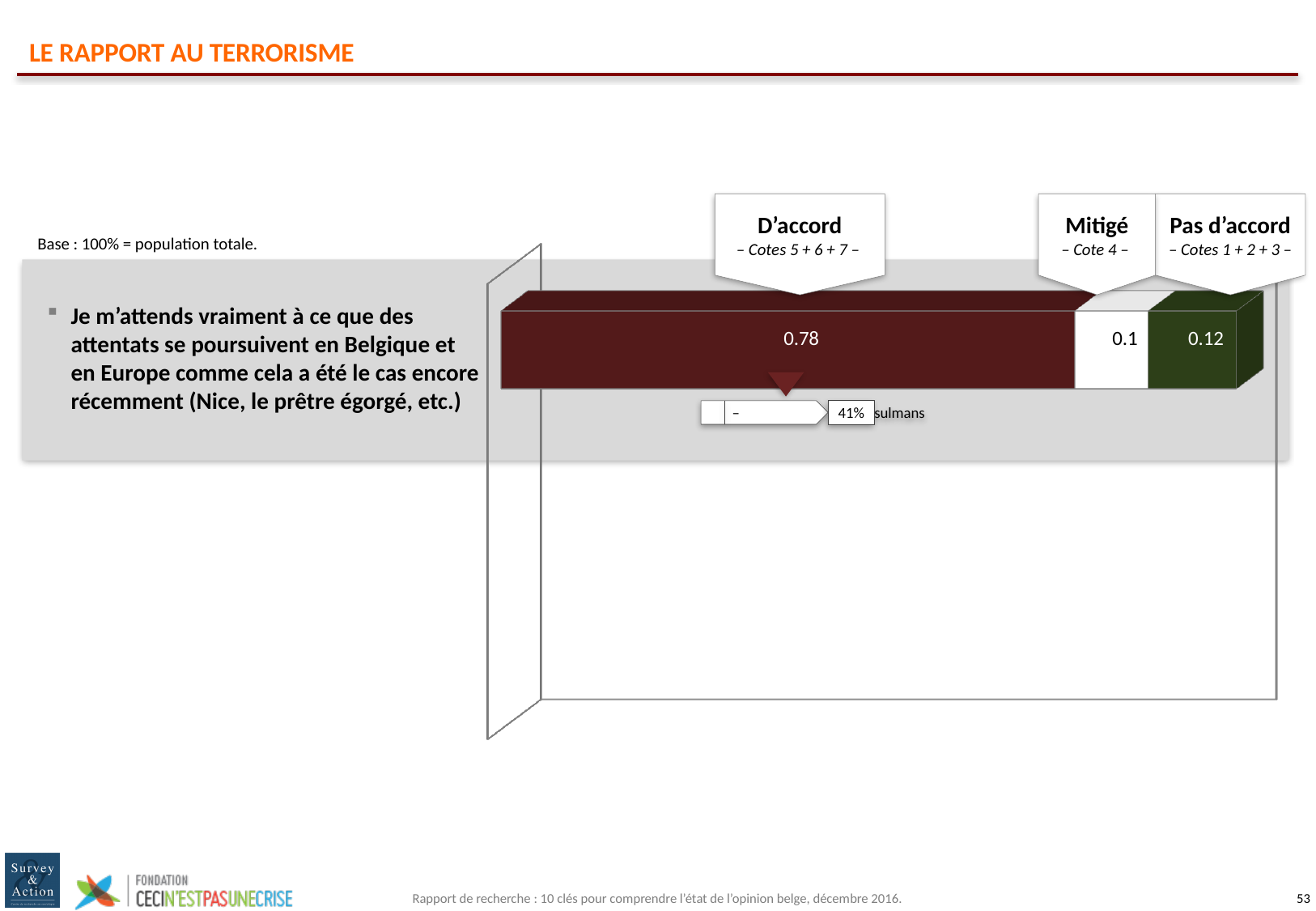
Which rating scores ('cotes') make up the 'D'accord' segment according to its label? Cotes 5 + 6 + 7 What kind of chart is shown on the slide? Stacked bar chart What is the value of the 'Mitigé' segment of the bar? 0.1 What is the difference between the 'Pas d'accord' value and the 'Mitigé' value? 0.02 How many segments does the stacked bar contain? 3 What is the difference between the 'D'accord' value and the 'Pas d'accord' value? 0.66 Which is larger, the 'D'accord' value or the 'Mitigé' value? D'accord What is the value of the 'Pas d'accord' segment of the bar? 0.12 What is the value of the 'D'accord' segment of the bar? 0.78 Which segment of the bar has the highest value? D'accord What is the total of the three segments of the stacked bar? 1 Which segment of the bar has the lowest value? Mitigé